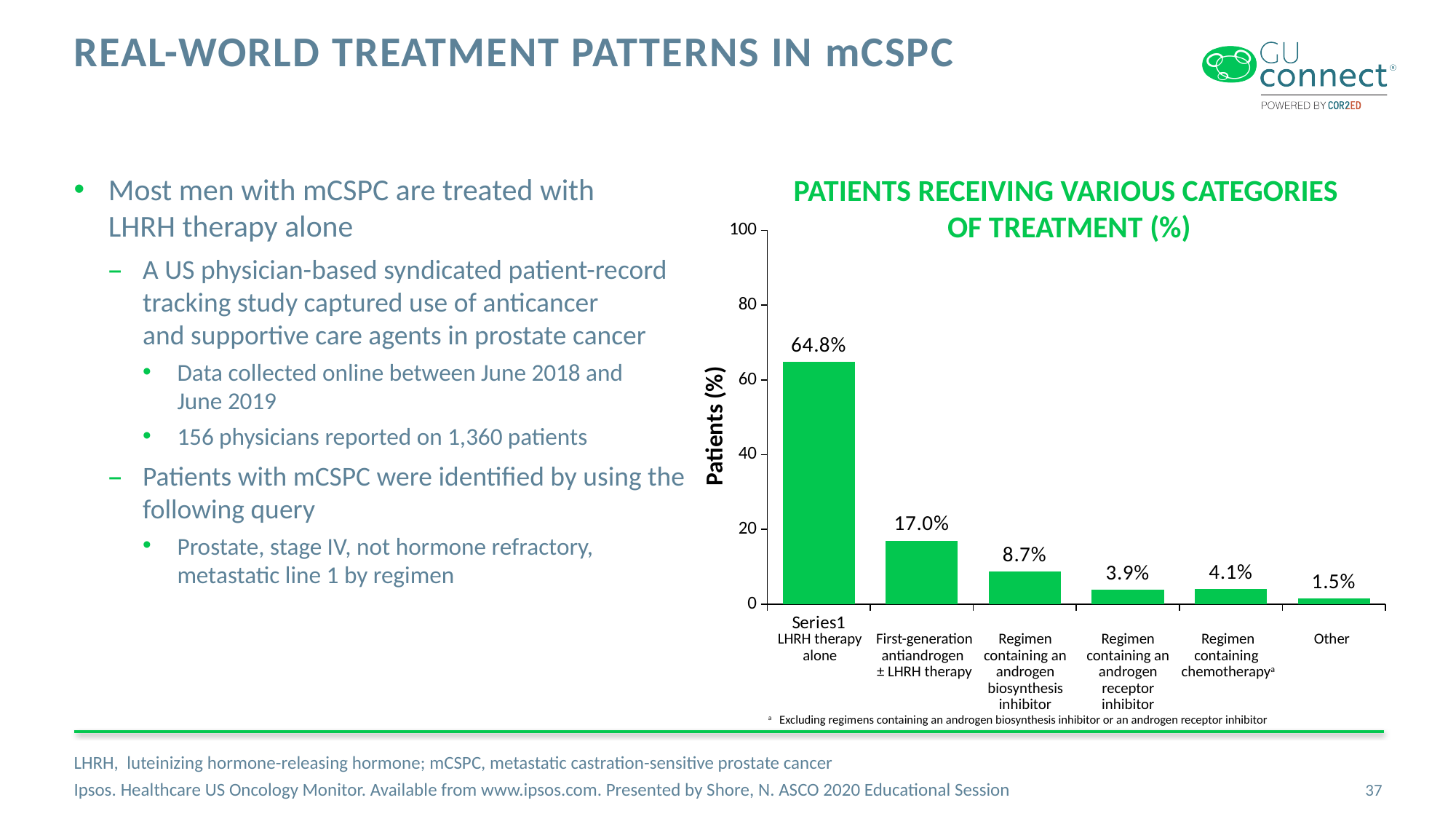
What percentage of patients received a regimen containing chemotherapy? 4.1% What is the label of the y axis of the chart? Patients (%) How many treatment categories are shown on the x axis of the chart? 6 What is the difference in percentage points between LHRH therapy alone and first-generation antiandrogen ± LHRH therapy? 47.8 Which is larger: the value for the regimen containing an androgen biosynthesis inhibitor or the regimen containing chemotherapy? Regimen containing an androgen biosynthesis inhibitor What percentage of patients received first-generation antiandrogen ± LHRH therapy? 17.0% Which treatment category has the lowest percentage of patients? Other What percentage of patients received LHRH therapy alone? 64.8% Which treatment category has the highest percentage of patients? LHRH therapy alone What kind of chart is shown on the slide? Bar chart What is the value for the 'Other' category? 1.5% What is the value for the regimen containing an androgen biosynthesis inhibitor? 8.7%